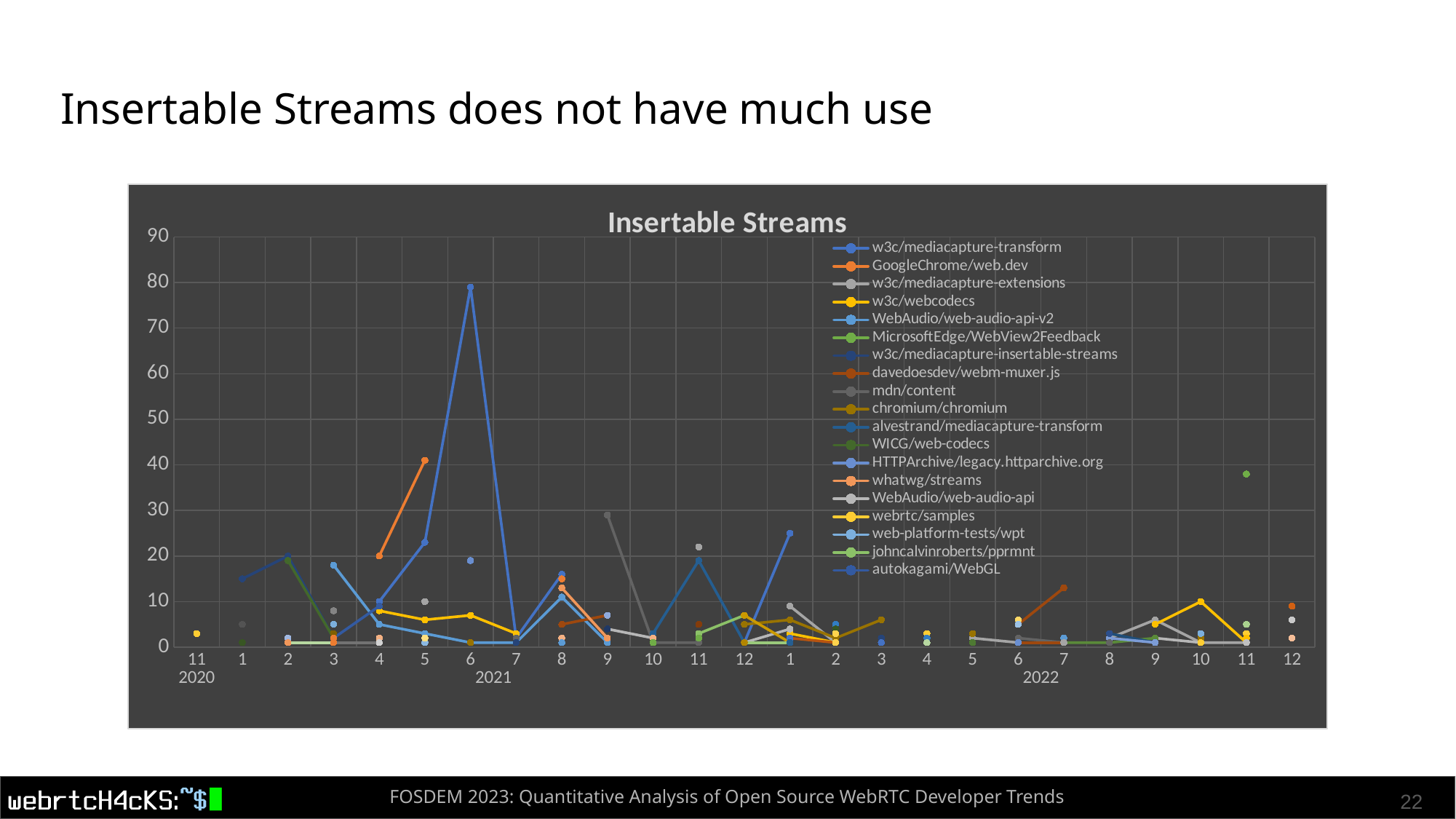
Is the value for MicrosoftEdge/WebView2Feedback in month 11 of 2022 greater or less than 30? greater What is the title of the chart? Insertable Streams What is the maximum value shown on the vertical axis? 90 Is the value for w3c/mediacapture-transform in month 1 of 2022 greater or less than 20? greater What type of chart is shown on the slide? line chart How many month labels are shown along the x axis? 25 Which is larger: the value for w3c/mediacapture-transform in month 6 of 2021 or the value for GoogleChrome/web.dev in month 5 of 2021? w3c/mediacapture-transform in month 6 of 2021 Which series reaches the highest value anywhere on the chart? w3c/mediacapture-transform Is the value for mdn/content in month 9 of 2021 greater or less than 20? greater How many series does the chart legend list? 19